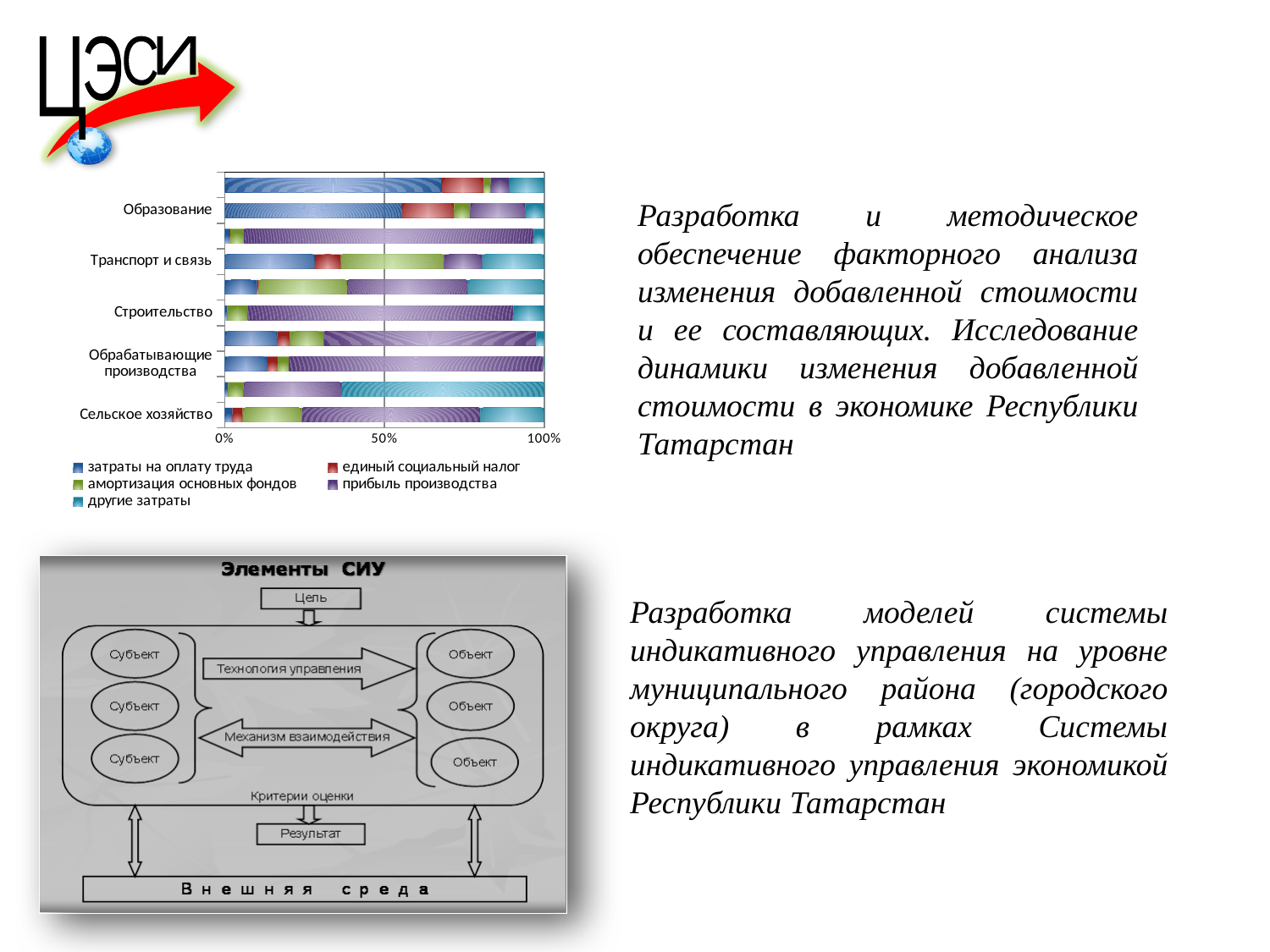
What tick values are printed on the horizontal axis of the stacked bar chart? 0%, 50%, 100% In the stacked bar chart, is the 'затраты на оплату труда' share for Транспорт и связь greater or less than 50%? less How many series does the legend of the stacked bar chart list? 5 Which series names appear in the legend of the stacked bar chart? затраты на оплату труда, единый социальный налог, амортизация основных фондов, прибыль производства, другие затраты In the stacked bar chart, is the 'затраты на оплату труда' share for Обрабатывающие производства greater or less than 50%? less Which category label is at the top of the vertical axis of the stacked bar chart? Образование In the stacked bar chart, for Сельское хозяйство, which segment is larger: 'прибыль производства' or 'затраты на оплату труда'? прибыль производства What kind of chart is shown in the upper left of the slide? Stacked bar chart In the stacked bar chart, is the 'затраты на оплату труда' share for Сельское хозяйство greater or less than 50%? less In the stacked bar chart, for Строительство, which segment is larger: 'прибыль производства' or 'единый социальный налог'? прибыль производства How many category labels are printed on the vertical axis of the stacked bar chart? 5